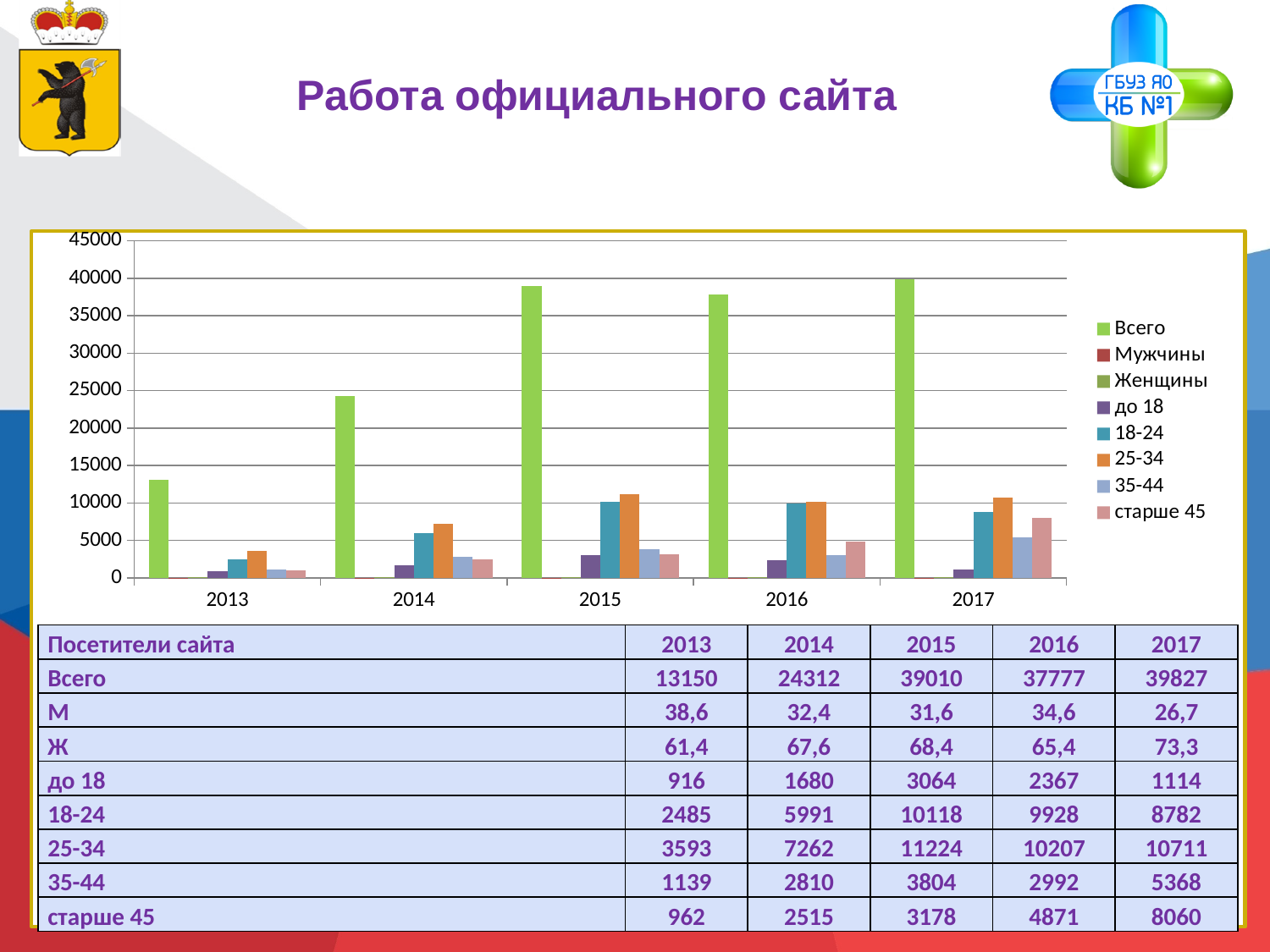
Does the старше 45 series rise or fall from 2013 to 2017? rises What is the difference between the Всего values for 2017 and 2013? 26677 In 2017, which is larger: the 25-34 series or the 18-24 series? 25-34 Is the Всего value for 2014 greater or less than 20000? greater What is the value of the 25-34 series for 2015? 11224 How many series does the chart legend list? 8 What kind of chart is shown on the slide? bar chart What colour are the Всего bars in the chart? green What is the value of старше 45 for 2013? 962 In which year is the Всего value lowest? 2013 What is the value of Всего for 2017? 39827 How many years (categories) are shown on the x axis of the chart? 5